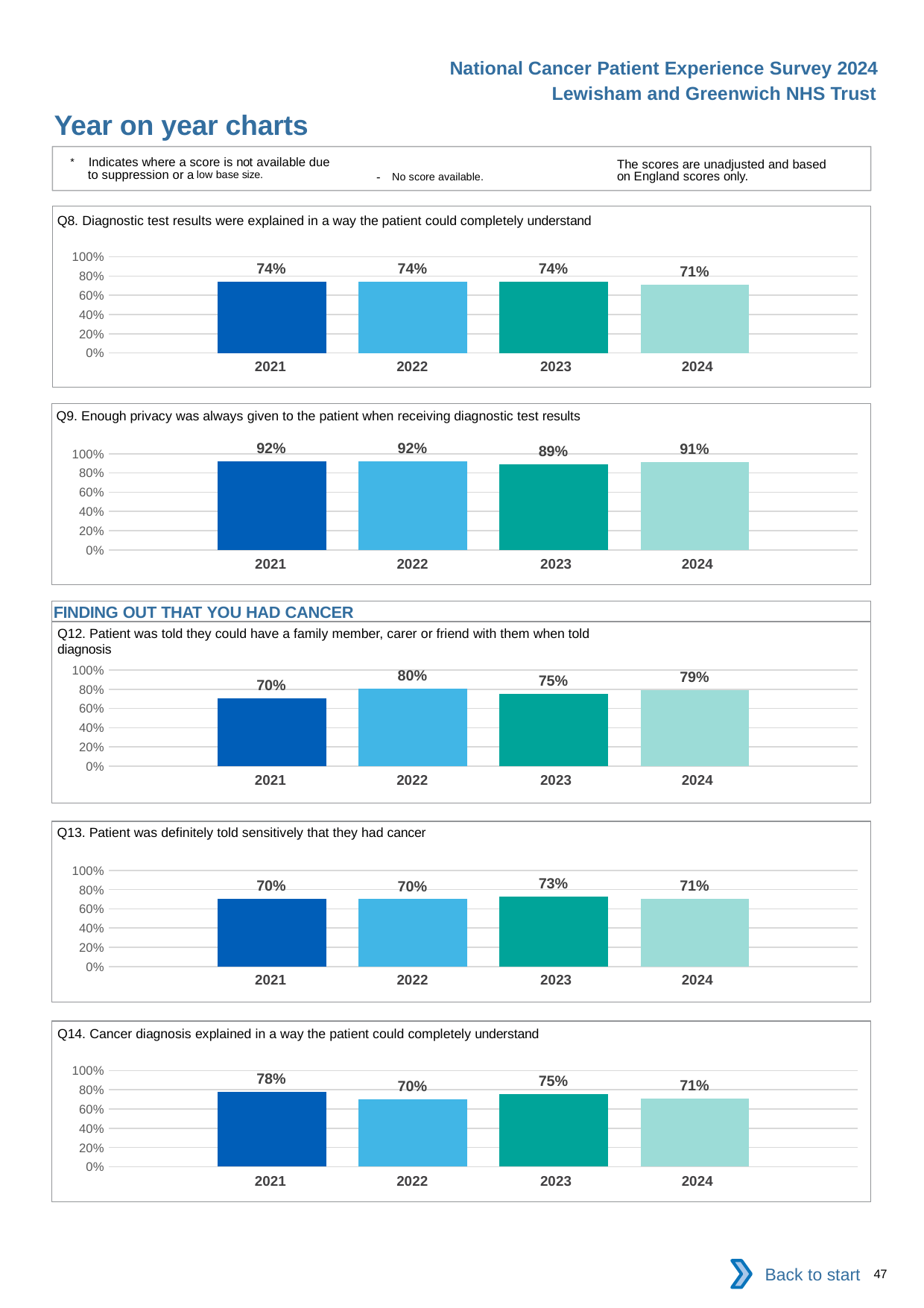
In the Q9 chart (Enough privacy was always given to the patient when receiving diagnostic test results), which year has the lowest value? 2023 In the Q8 chart (Diagnostic test results were explained in a way the patient could completely understand), what is the value for 2024? 71% How many charts are shown on the slide? 5 In the Q14 chart (Cancer diagnosis explained in a way the patient could completely understand), which year has the highest value? 2021 What kind of chart is the Q13 chart (Patient was definitely told sensitively that they had cancer)? Bar chart In the Q12 chart (Patient was told they could have a family member, carer or friend with them when told diagnosis), which year has the highest value? 2022 In the Q9 chart (Enough privacy was always given to the patient when receiving diagnostic test results), is the value for 2024 greater or less than 80%? greater In the Q12 chart (Patient was told they could have a family member, carer or friend with them when told diagnosis), what is the value for 2021? 70% In the Q9 chart (Enough privacy was always given to the patient when receiving diagnostic test results), what is the difference between the 2022 and 2023 values? 3 percentage points In the Q14 chart (Cancer diagnosis explained in a way the patient could completely understand), what is the difference between the 2021 and 2022 values? 8 percentage points How many years are shown on the x axis of the Q8 chart (Diagnostic test results were explained in a way the patient could completely understand)? 4 In the Q13 chart (Patient was definitely told sensitively that they had cancer), which is larger, the value for 2023 or the value for 2024? 2023